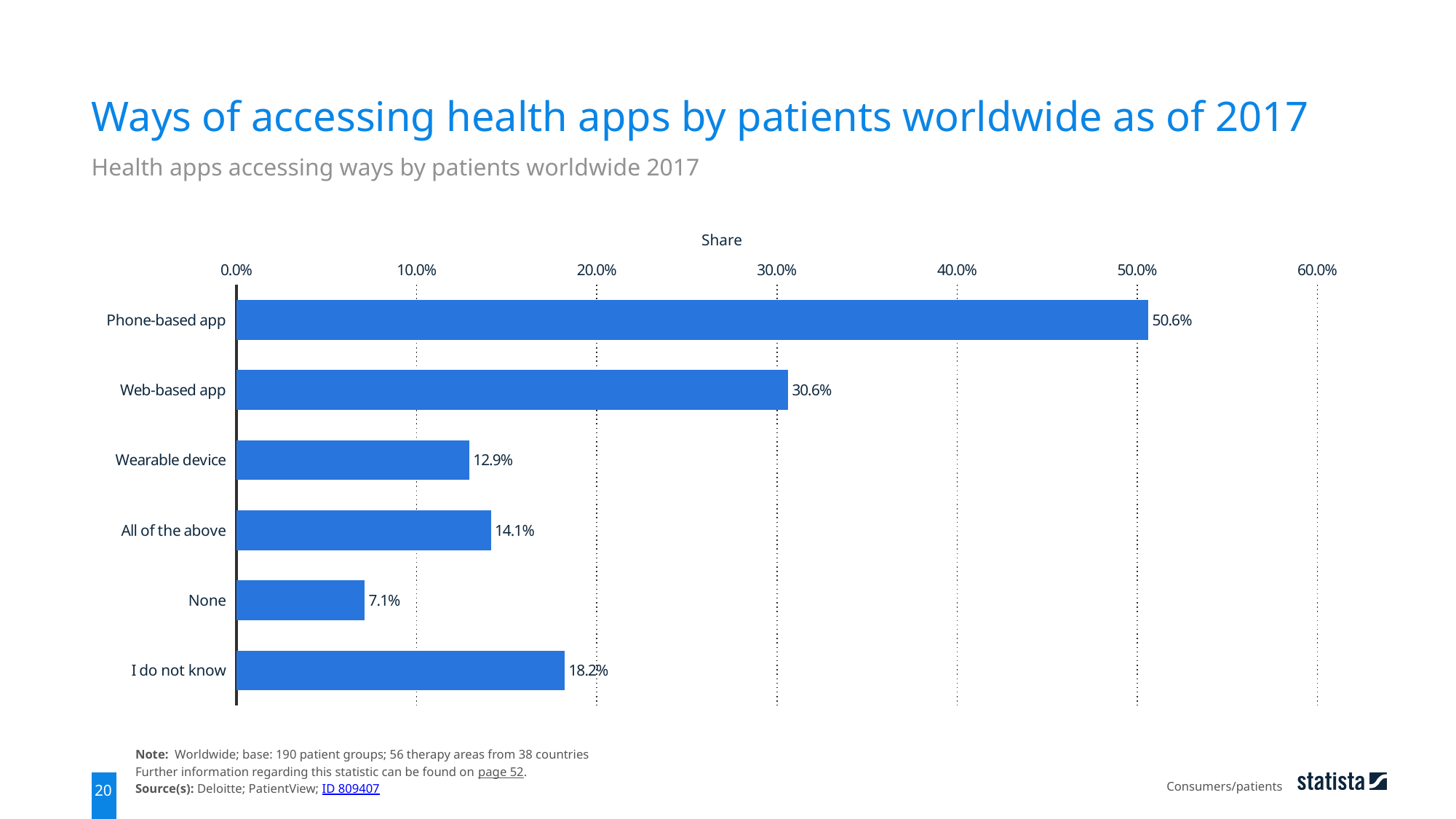
Is the share for Web-based app greater or less than 30.0%? greater What is the share for I do not know? 18.2% What is the difference in share between Phone-based app and Web-based app? 20.0% What is the share for Wearable device? 12.9% What is the label of the horizontal axis? Share What is the difference in share between All of the above and Wearable device? 1.2% Which has a larger share, Web-based app or I do not know? Web-based app How many categories are shown in the chart? 6 Which category has the highest share? Phone-based app What is the share for Phone-based app? 50.6% Which category has the lowest share? None What kind of chart is shown on the slide? Bar chart